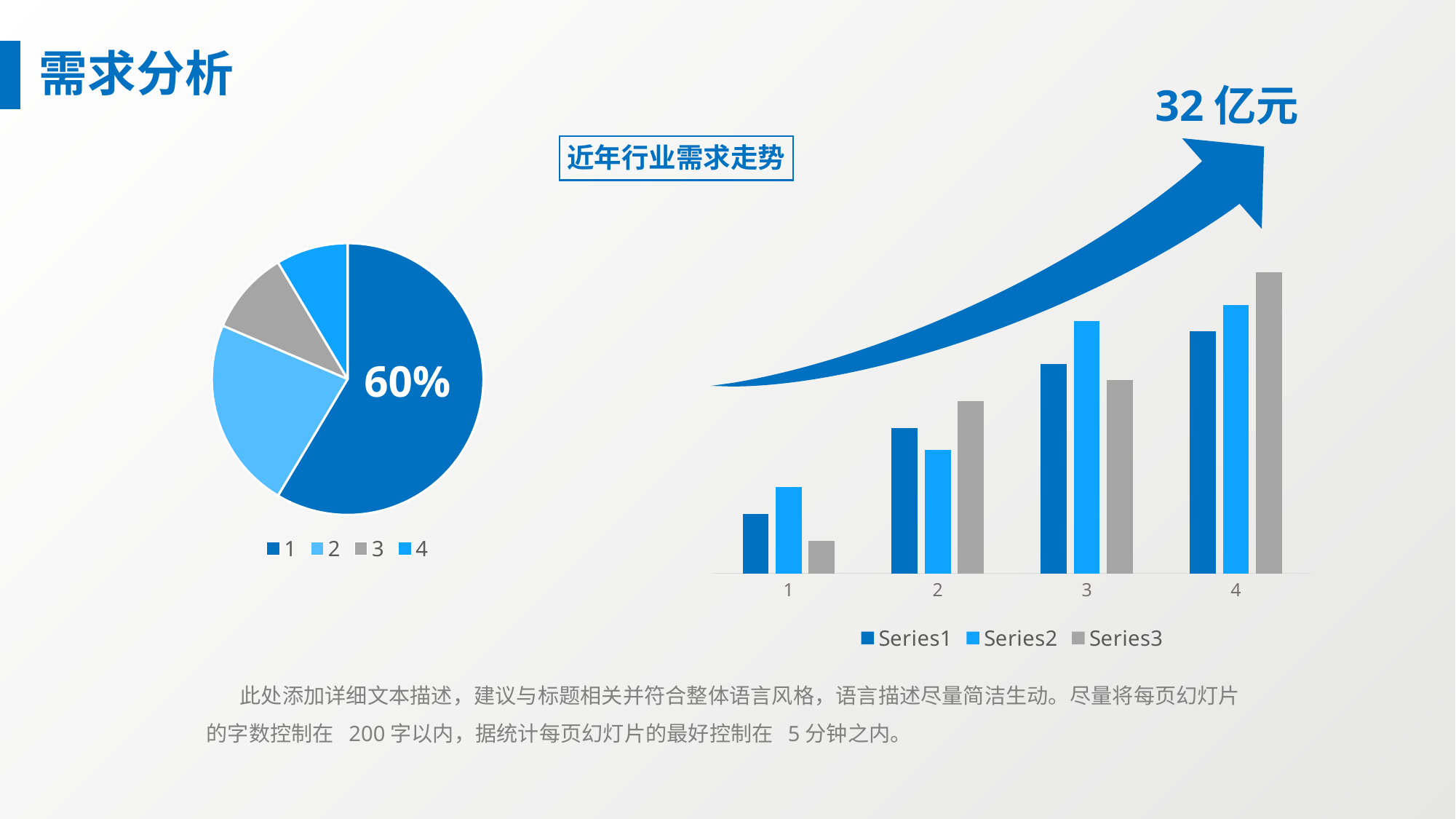
How many series does the legend of the chart titled 近年行业需求走势 list? 3 What kind of chart is the chart on the left of the slide? pie chart In the pie chart on the left, what share does slice 1 have? 60% In the chart titled 近年行业需求走势, which category has the lowest Series2 value? 1 In the chart titled 近年行业需求走势, which category has the highest Series3 value? 4 How many slices does the pie chart on the left have? 4 In the chart titled 近年行业需求走势, do the Series1 values rise or fall from category 1 to category 4? rise In the pie chart on the left, which is larger, slice 1 or slice 2? 1 What kind of chart is the chart titled 近年行业需求走势? bar chart In the pie chart on the left, which slice is the largest? 1 How many categories are on the x axis of the chart titled 近年行业需求走势? 4 In the chart titled 近年行业需求走势, at category 1, which is larger, Series2 or Series3? Series2